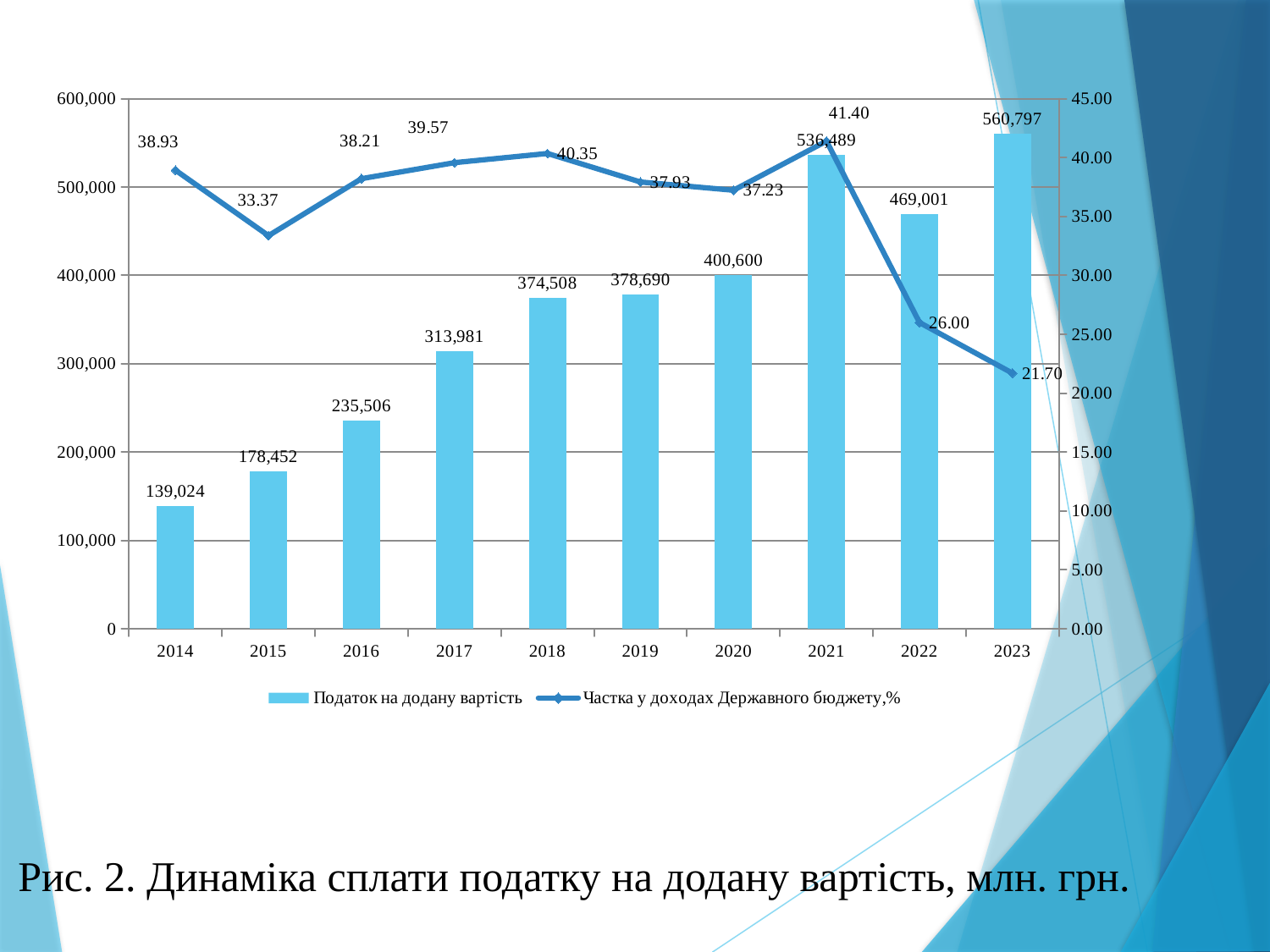
Which is larger, the Податок на додану вартість value for 2021 or for 2022? 2021 What is the value of Частка у доходах Державного бюджету,% for 2018? 40.35 Which year has the highest value of Податок на додану вартість? 2023 Which year has the highest value of Частка у доходах Державного бюджету,%? 2021 Does the Частка у доходах Державного бюджету,% line rise or fall from 2021 to 2023? Fall How many years are shown on the x axis? 10 Which year has the lowest value of Частка у доходах Державного бюджету,%? 2023 What is the difference between the Податок на додану вартість values for 2023 and 2022? 91,796 How many series does the legend list? 2 What kind of chart is shown on the slide? Combined bar and line chart What is the value of Податок на додану вартість for 2014? 139,024 What is the value of Податок на додану вартість for 2021? 536,489